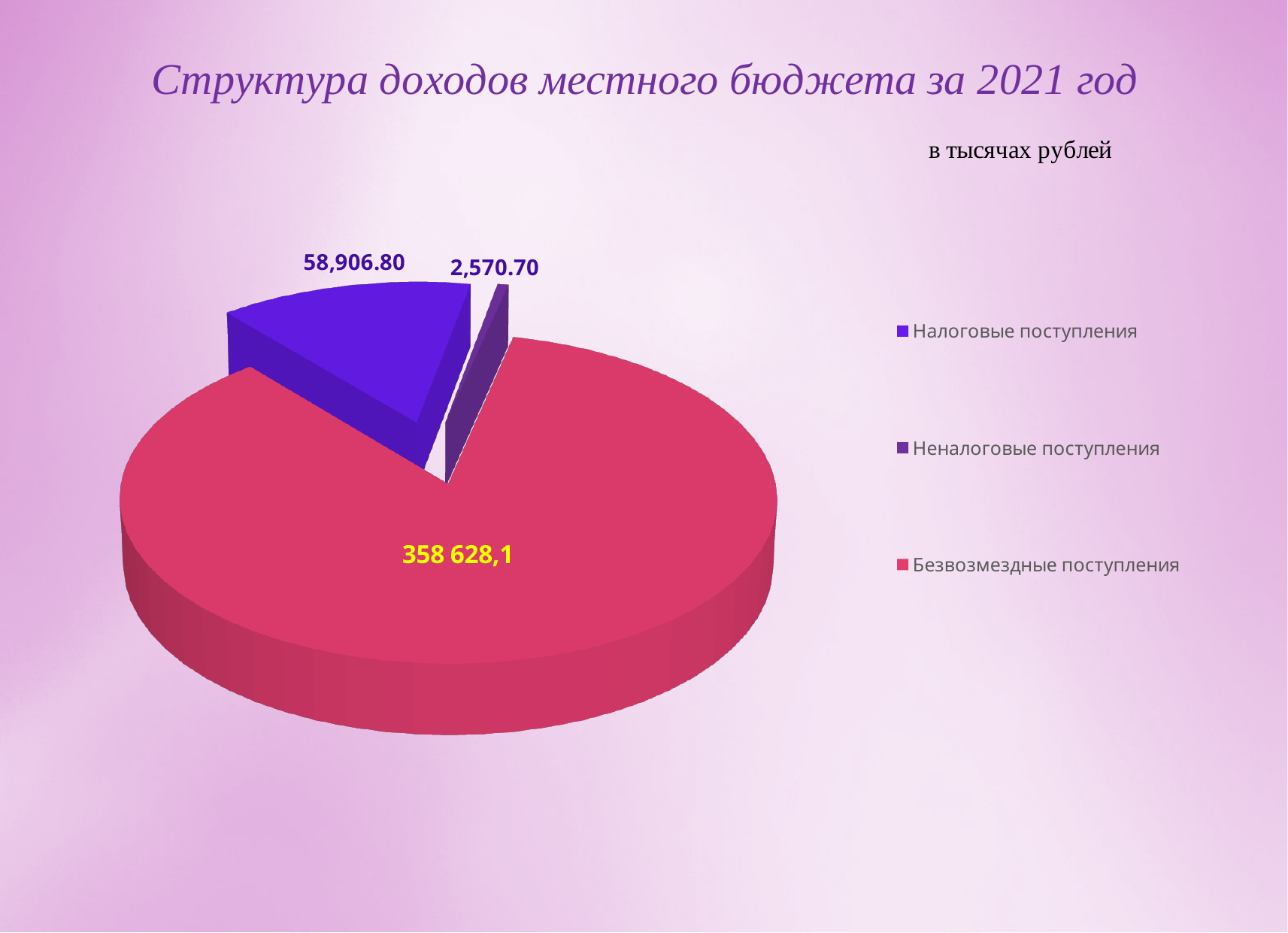
How many slices does the pie chart have? 3 What is the value for Неналоговые поступления? 2,570.70 Which is larger, Налоговые поступления or Неналоговые поступления? Налоговые поступления What is the value for Налоговые поступления? 58,906.80 Which category has the smallest slice of the pie? Неналоговые поступления What is the total of all three slices? 420,105.60 What is the title of the chart? Структура доходов местного бюджета за 2021 год What is the difference between Налоговые поступления and Неналоговые поступления? 56,336.10 What share of the pie does Безвозмездные поступления represent? 85.4% What is the value for Безвозмездные поступления? 358 628,1 Which category has the largest slice of the pie? Безвозмездные поступления What type of chart is shown on the slide? Pie chart